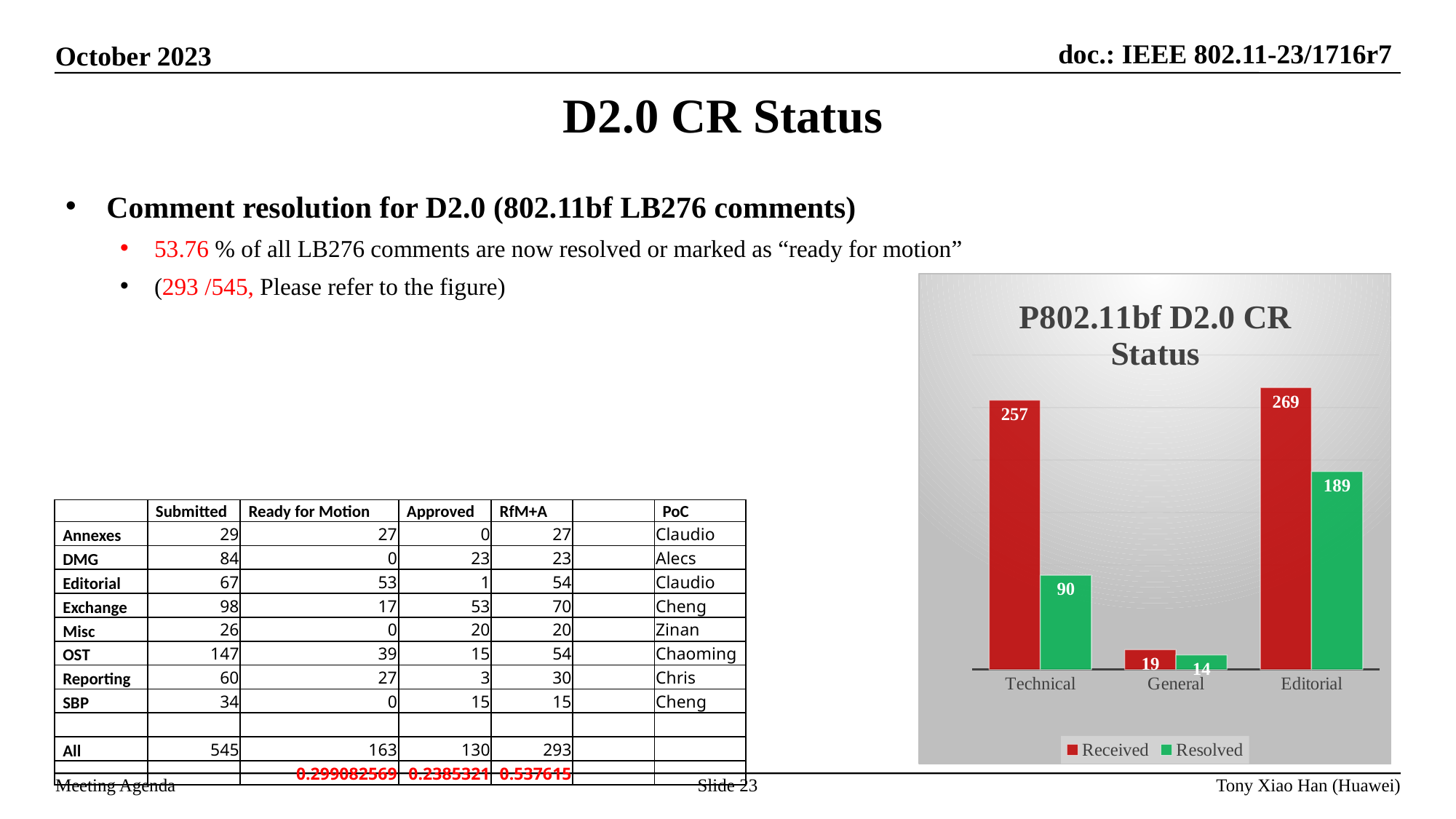
What is the difference between Received and Resolved for Technical? 167 Which category has the highest Received value? Editorial What kind of chart is shown? bar chart What is the Resolved value for General? 14 What is the Resolved value for Editorial? 189 What is the difference between Received and Resolved for Editorial? 80 Which is larger, the Resolved value for Technical or the Resolved value for Editorial? Editorial How many series does the legend list? 2 What is the Received value for Technical? 257 How many categories are shown on the x axis? 3 Which category has the lowest Resolved value? General What is the title of the chart? P802.11bf D2.0 CR Status